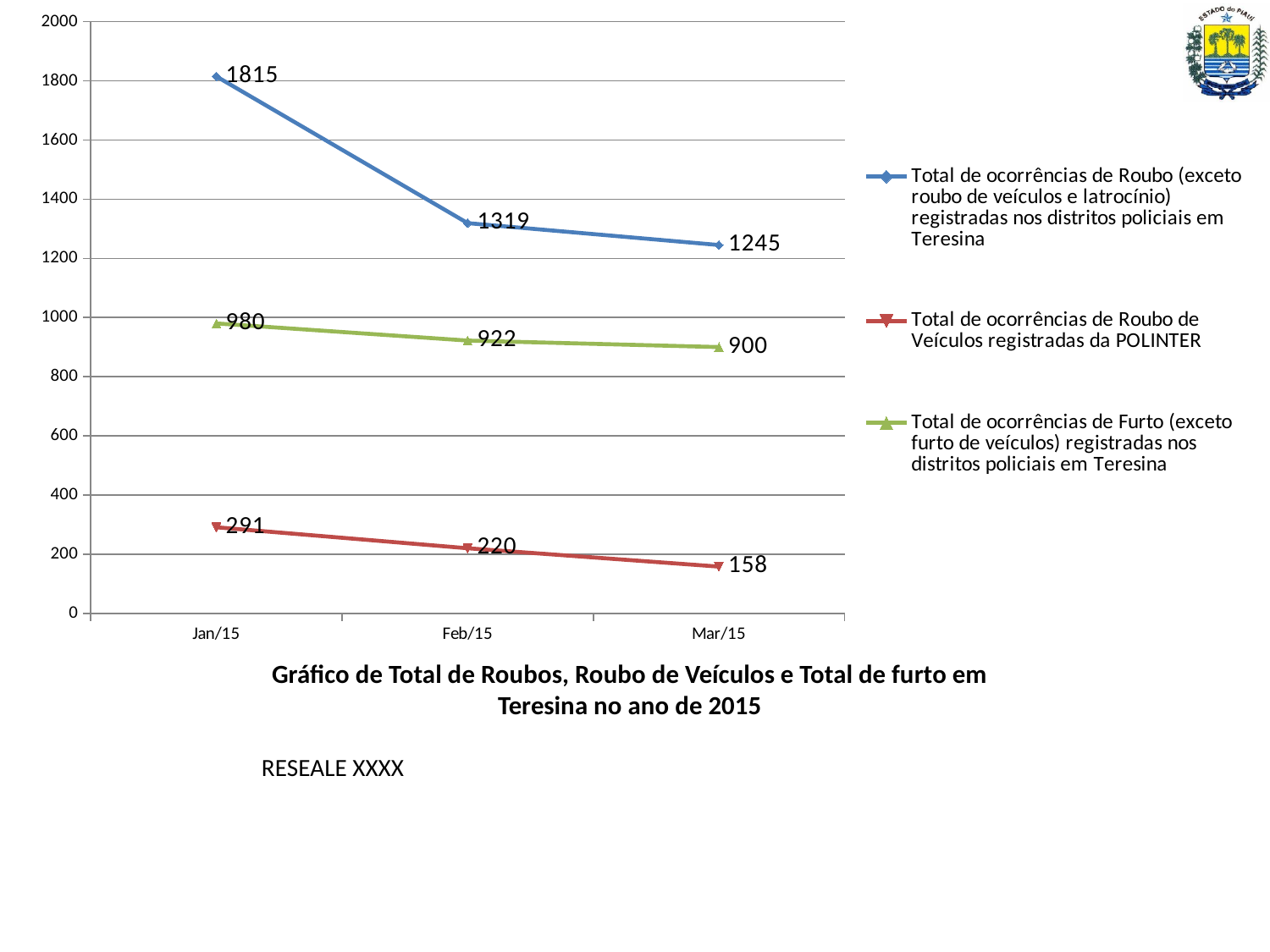
What kind of chart is shown? Line chart What is the value of Total de ocorrências de Furto (exceto furto de veículos) in Feb/15? 922 In which month is the Total de ocorrências de Roubo de Veículos series lowest? Mar/15 How many series does the legend list? 3 How many months are shown on the x axis? 3 What is the value of Total de ocorrências de Roubo de Veículos registradas da POLINTER in Mar/15? 158 In which month is the Total de ocorrências de Roubo (exceto roubo de veículos e latrocínio) series highest? Jan/15 What is the value of Total de ocorrências de Roubo (exceto roubo de veículos e latrocínio) in Jan/15? 1815 What is the difference between the Furto series and the Roubo de Veículos series in Mar/15? 742 Do the values of the Total de ocorrências de Furto series rise or fall from Jan/15 to Mar/15? Fall Which is larger in Feb/15: the Furto series or the Roubo de Veículos series? Furto series What is the difference between the Jan/15 and Feb/15 values of Total de ocorrências de Roubo (exceto roubo de veículos e latrocínio)? 496